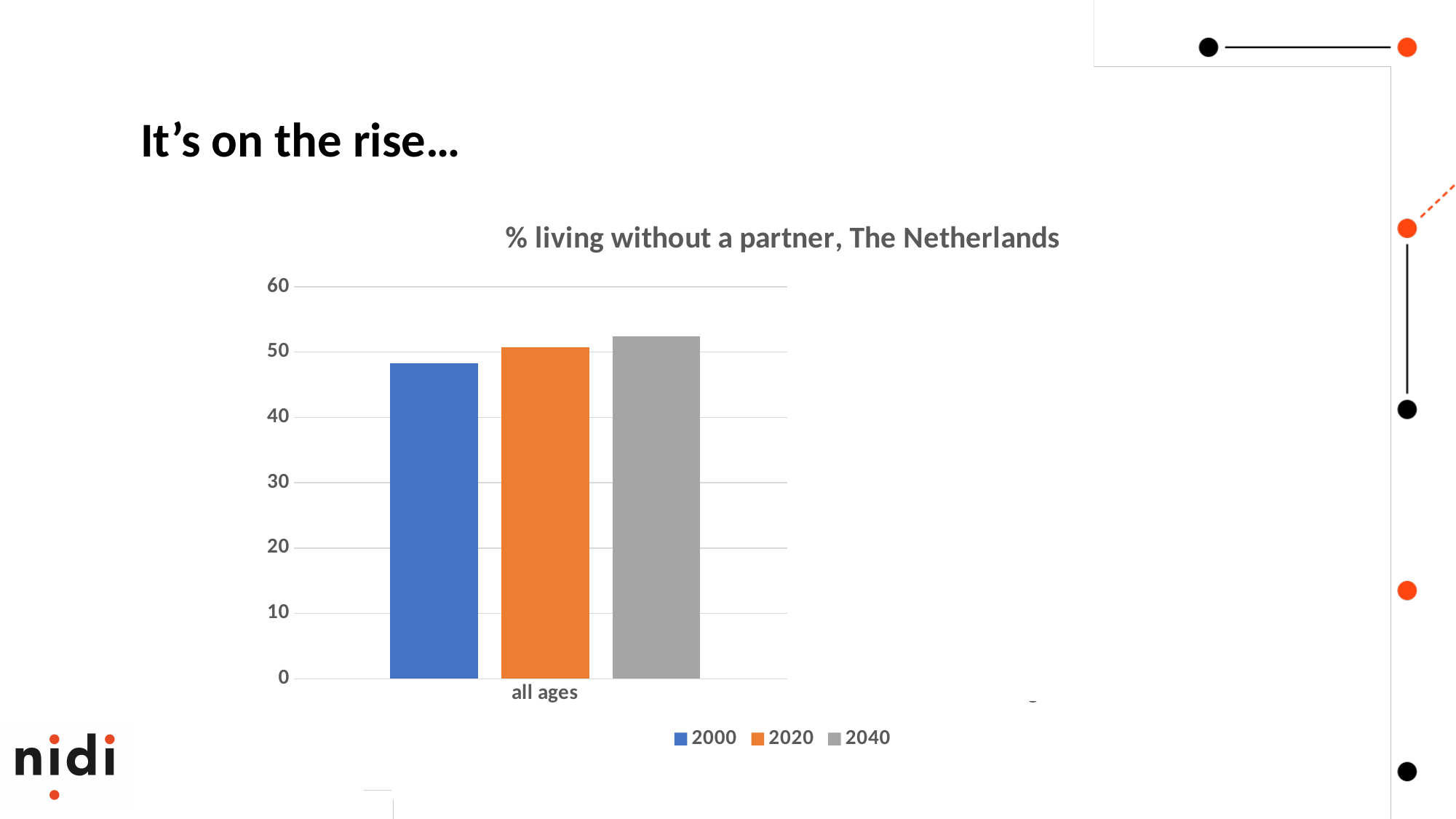
Is the value for 2040 greater or less than 50? greater How many series does the legend list? 3 Which colour represents the 2020 series in the legend? orange Is the value for 2000 greater or less than 50? less Which year has the highest bar for all ages? 2040 How many categories are shown on the x axis? 1 Is the value for 2000 greater or less than 40? greater What is the title of the chart? % living without a partner, The Netherlands Which is larger, the value for 2000 or the value for 2040? 2040 What kind of chart is shown on the slide? bar chart Which year has the lowest bar for all ages? 2000 Do the values rise or fall from 2000 to 2040? rise